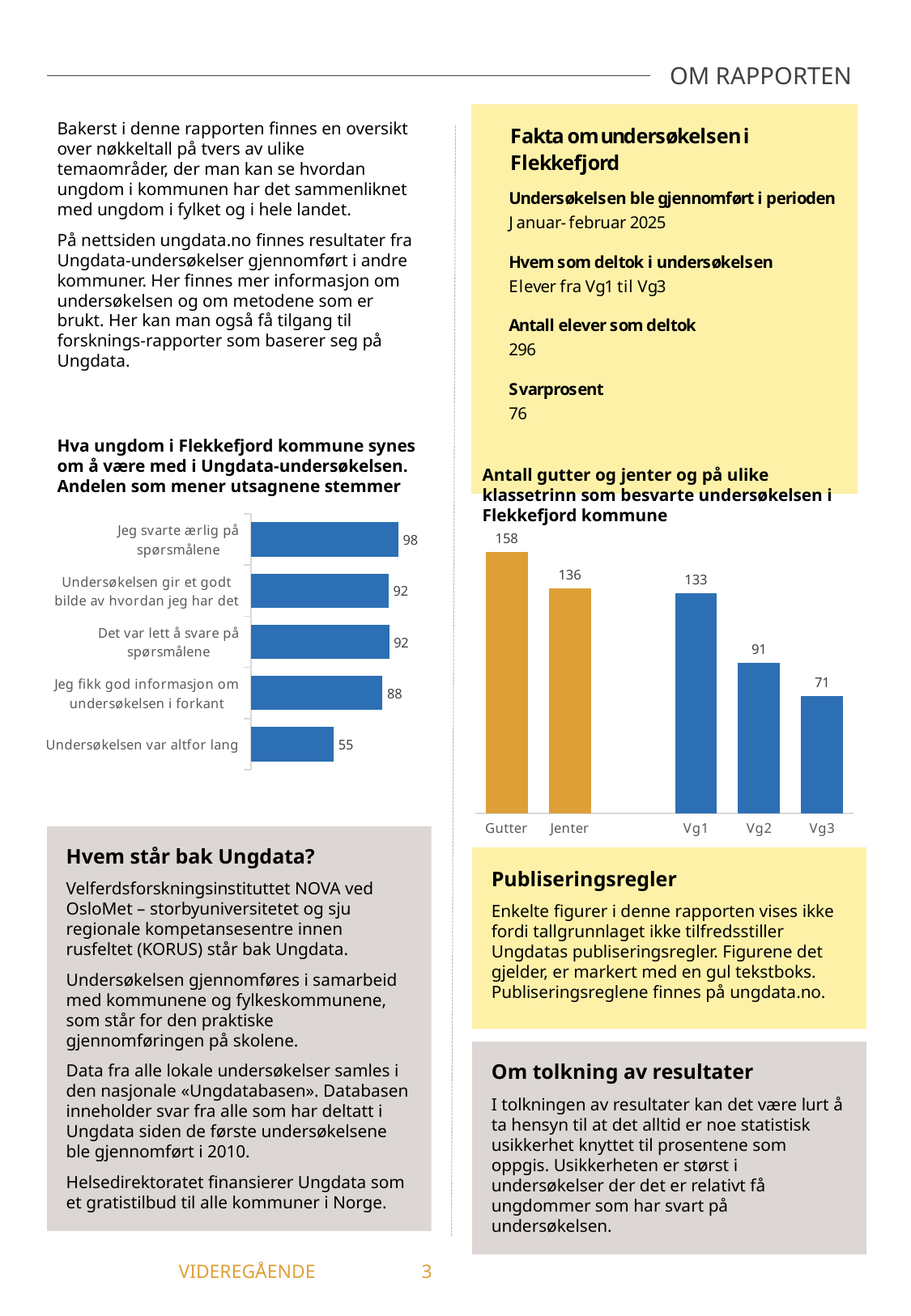
In the chart 'Antall gutter og jenter og på ulike klassetrinn som besvarte undersøkelsen i Flekkefjord kommune', what is the value for Gutter? 158 In the chart 'Hva ungdom i Flekkefjord kommune synes om å være med i Ungdata-undersøkelsen', which statement has the lowest value? Undersøkelsen var altfor lang In the chart 'Antall gutter og jenter og på ulike klassetrinn som besvarte undersøkelsen i Flekkefjord kommune', which category has the highest value? Gutter In the chart 'Antall gutter og jenter og på ulike klassetrinn som besvarte undersøkelsen i Flekkefjord kommune', which is larger, Jenter or Vg1? Jenter In the chart 'Hva ungdom i Flekkefjord kommune synes om å være med i Ungdata-undersøkelsen', what is the value for 'Undersøkelsen var altfor lang'? 55 In the chart 'Antall gutter og jenter og på ulike klassetrinn som besvarte undersøkelsen i Flekkefjord kommune', do the values rise or fall from Vg1 to Vg3? Fall In the chart 'Hva ungdom i Flekkefjord kommune synes om å være med i Ungdata-undersøkelsen', what is the value for 'Jeg svarte ærlig på spørsmålene'? 98 In the chart 'Antall gutter og jenter og på ulike klassetrinn som besvarte undersøkelsen i Flekkefjord kommune', what is the value for Vg2? 91 In the chart 'Antall gutter og jenter og på ulike klassetrinn som besvarte undersøkelsen i Flekkefjord kommune', what is the difference between Gutter and Jenter? 22 What kind of chart is 'Hva ungdom i Flekkefjord kommune synes om å være med i Ungdata-undersøkelsen'? Bar chart In the chart 'Hva ungdom i Flekkefjord kommune synes om å være med i Ungdata-undersøkelsen', how many statements are shown? 5 In the chart 'Hva ungdom i Flekkefjord kommune synes om å være med i Ungdata-undersøkelsen', what is the difference between 'Jeg svarte ærlig på spørsmålene' and 'Jeg fikk god informasjon om undersøkelsen i forkant'? 10